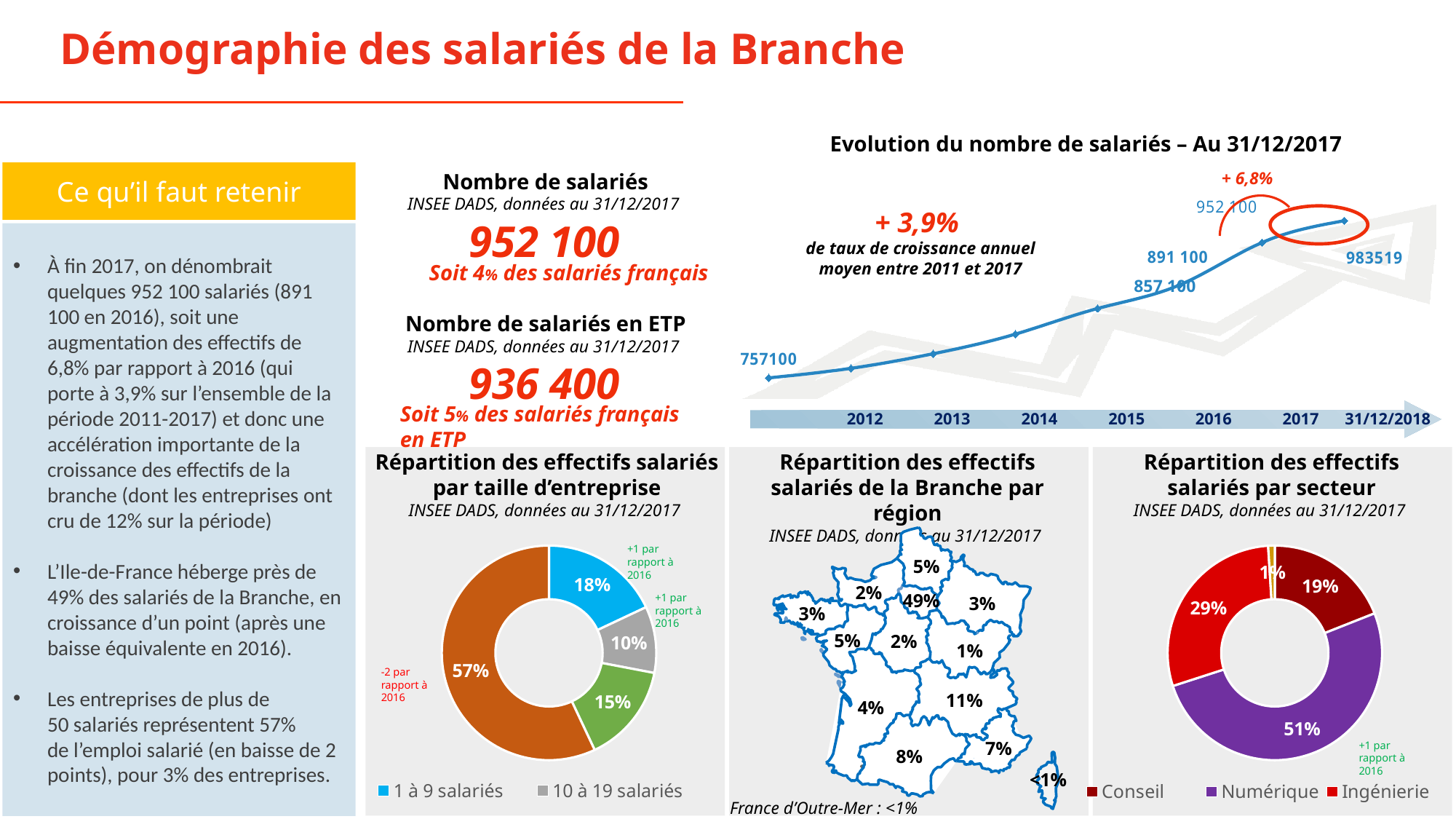
In the 'Evolution du nombre de salariés' chart, what is the difference between the 2017 value and the 2016 value? 61 000 What kind of chart is the 'Evolution du nombre de salariés – Au 31/12/2017' chart? line chart How many entries does the legend of the 'Répartition des effectifs salariés par secteur' chart list? 3 In the 'Répartition des effectifs salariés par secteur' chart, which sector has the largest share? Numérique In the 'Evolution du nombre de salariés' chart, what is the value for 2016? 891 100 How many slices does the 'Répartition des effectifs salariés par taille d'entreprise' chart have? 4 In the 'Evolution du nombre de salariés' chart, do the values rise or fall from left to right? rise In the 'Répartition des effectifs salariés par secteur' chart, what is the share for Numérique? 51% In the 'Répartition des effectifs salariés par secteur' chart, which is larger, Conseil or Ingénierie? Ingénierie In the 'Répartition des effectifs salariés par taille d'entreprise' chart, what is the share for '1 à 9 salariés'? 18% In the 'Evolution du nombre de salariés' chart, what is the value for 2017? 952 100 In the 'Répartition des effectifs salariés par taille d'entreprise' chart, what is the difference between the '1 à 9 salariés' share and the '10 à 19 salariés' share? 8%